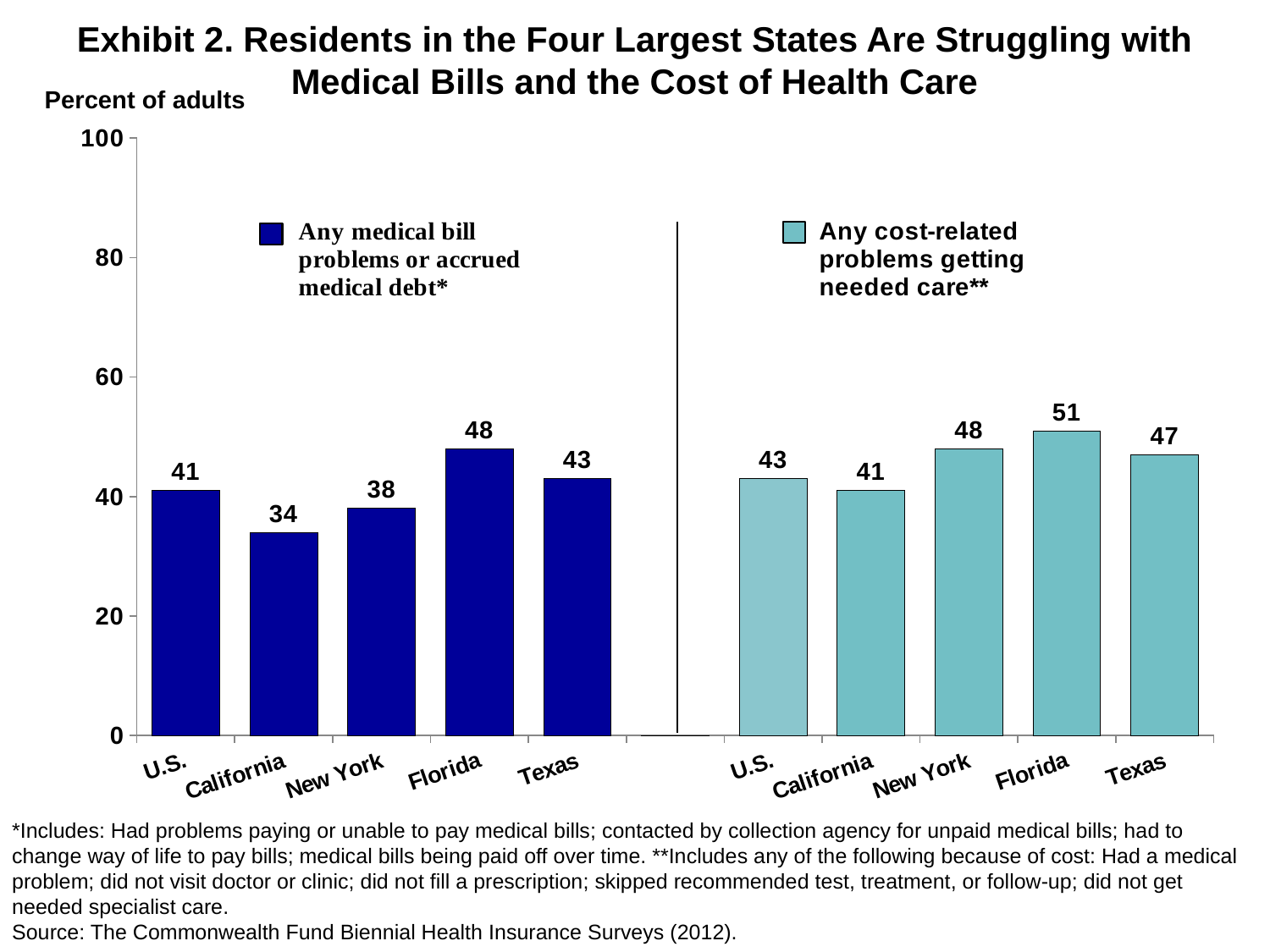
Which is larger: Texas in the 'Any medical bill problems or accrued medical debt' series or Texas in the 'Any cost-related problems getting needed care' series? Texas in the 'Any cost-related problems getting needed care' series What is the label on the y axis? Percent of adults What is the value for the U.S. in the 'Any medical bill problems or accrued medical debt' series? 41 What is the value for California in the 'Any cost-related problems getting needed care' series? 41 What is the difference between Florida and California in the 'Any medical bill problems or accrued medical debt' series? 14 Which category has the lowest value in the 'Any medical bill problems or accrued medical debt' series? California How many categories are shown in each series? 5 What is the value for Florida in the 'Any medical bill problems or accrued medical debt' series? 48 How many series does the legend list? 2 Which state has the highest value in the 'Any cost-related problems getting needed care' series? Florida Is the value for New York in the 'Any medical bill problems or accrued medical debt' series greater or less than 40? less What kind of chart is shown on the slide? Bar chart